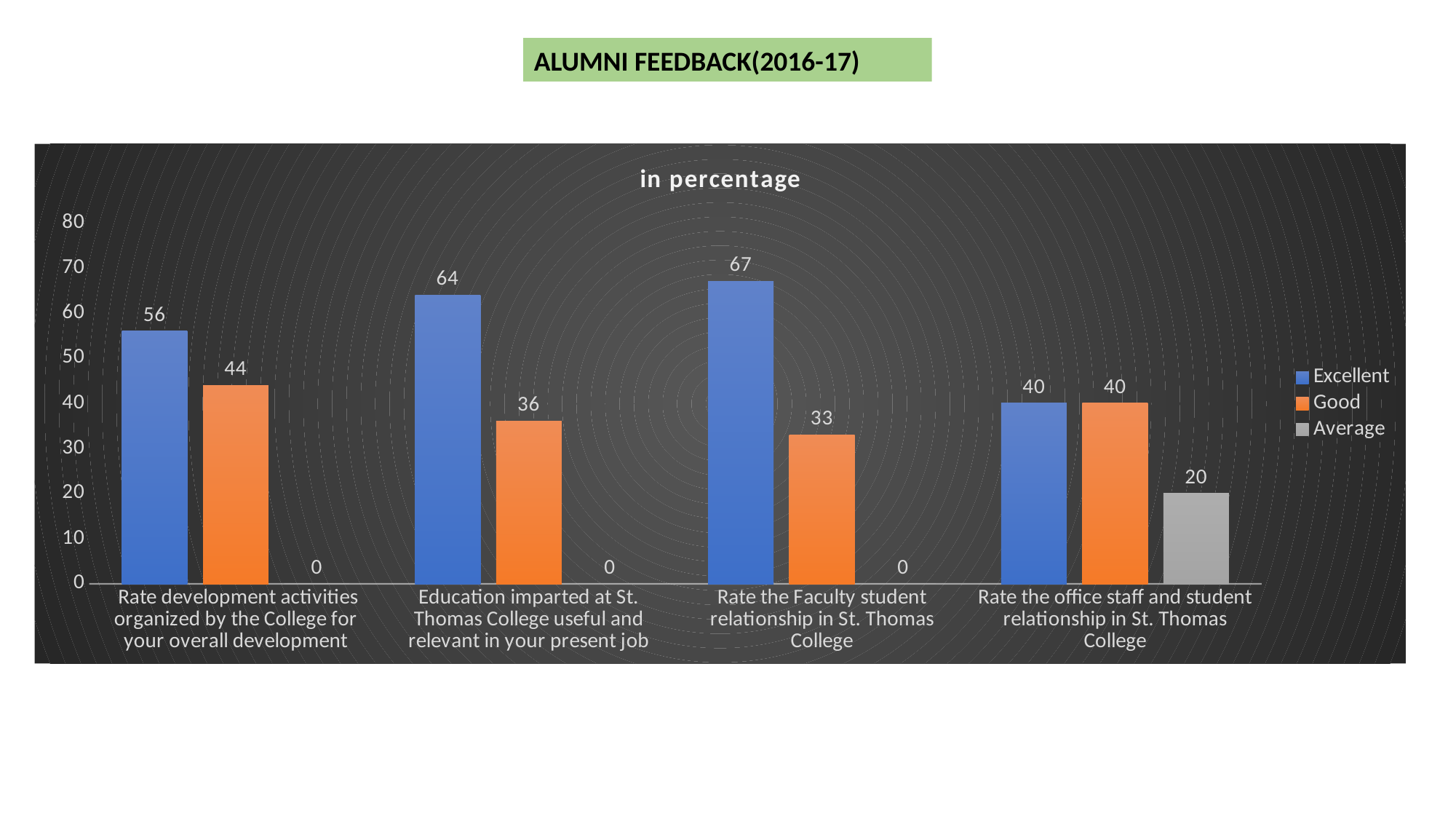
Which category has the lowest Good value? Rate the Faculty student relationship in St. Thomas College What is the Good value for "Education imparted at St. Thomas College useful and relevant in your present job"? 36 What kind of chart is shown on the slide? Bar chart What is the title of the chart? in percentage How many series does the legend list? 3 How many categories are shown on the x axis? 4 Which is larger for "Education imparted at St. Thomas College useful and relevant in your present job": the Excellent value or the Good value? Excellent Which category has the highest Excellent value? Rate the Faculty student relationship in St. Thomas College What is the difference between the Excellent and Good values for "Rate development activities organized by the College for your overall development"? 12 What is the Average value for "Rate the office staff and student relationship in St. Thomas College"? 20 Which colour represents the Average series in the legend? Grey What is the Excellent value for "Rate the Faculty student relationship in St. Thomas College"? 67